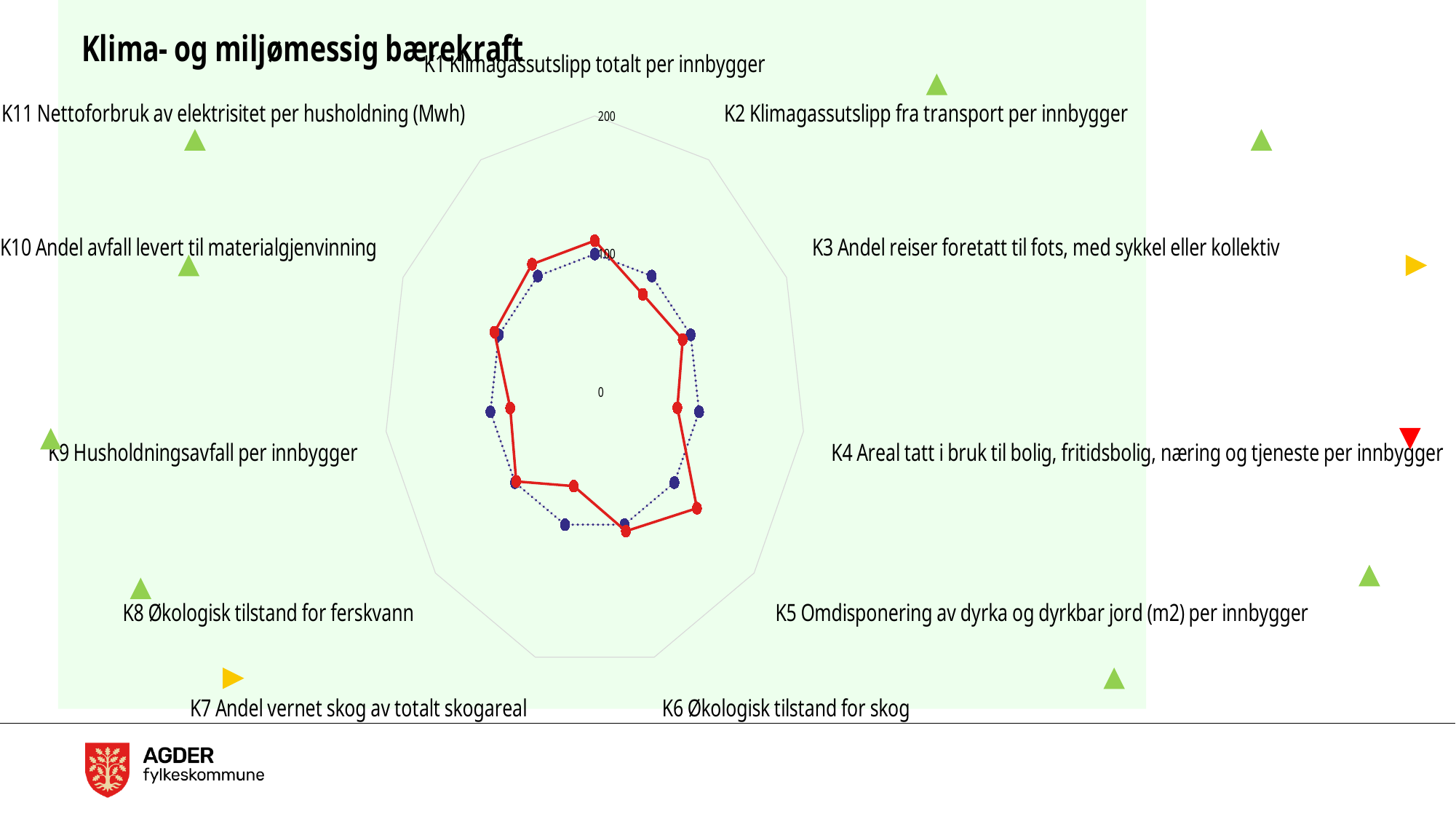
How many categories (axes) does the radar chart have? 11 Is the red series value for K9 Husholdningsavfall per innbygger greater or less than 100? less What is the title of the slide containing the radar chart? Klima- og miljømessig bærekraft What kind of chart is shown on the slide? Radar chart Is the red series value for K2 Klimagassutslipp fra transport per innbygger greater or less than 100? less Is the red series value for K5 Omdisponering av dyrka og dyrkbar jord (m2) per innbygger greater or less than 100? greater What is the highest value shown on the radar chart's axis scale? 200 For the red series, which category has the highest value? K5 Omdisponering av dyrka og dyrkbar jord (m2) per innbygger For the red series, which is larger: the value for K5 Omdisponering av dyrka og dyrkbar jord (m2) per innbygger or the value for K7 Andel vernet skog av totalt skogareal? K5 Omdisponering av dyrka og dyrkbar jord (m2) per innbygger